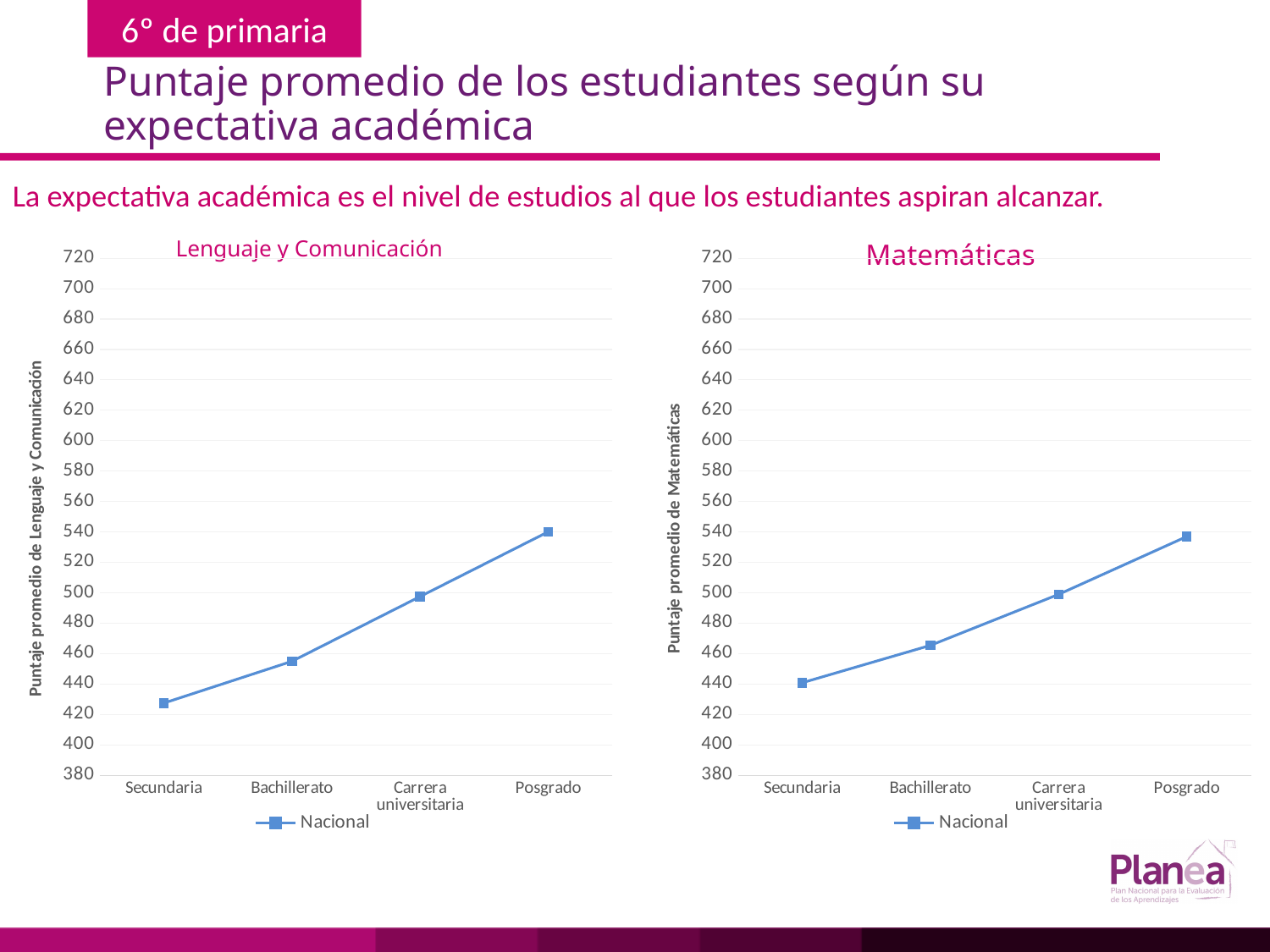
In the Matemáticas chart, is the value for Bachillerato greater or less than 480? less In the Lenguaje y Comunicación chart, which category has the highest value? Posgrado What is the y-axis label of the Lenguaje y Comunicación chart? Puntaje promedio de Lenguaje y Comunicación What kind of chart is the Lenguaje y Comunicación chart? line chart In the Matemáticas chart, is the value for Posgrado greater or less than 520? greater How many categories are shown on the x axis of the Matemáticas chart? 4 In the Matemáticas chart, which category has the lowest value? Secundaria What is the name of the series shown in the legend of the Matemáticas chart? Nacional In the Lenguaje y Comunicación chart, is the value for Secundaria greater or less than 440? less How many series does the legend of the Lenguaje y Comunicación chart list? 1 In the Lenguaje y Comunicación chart, which is larger, the value for Bachillerato or the value for Carrera universitaria? Carrera universitaria In the Matemáticas chart, do the values rise or fall from Secundaria to Posgrado? rise